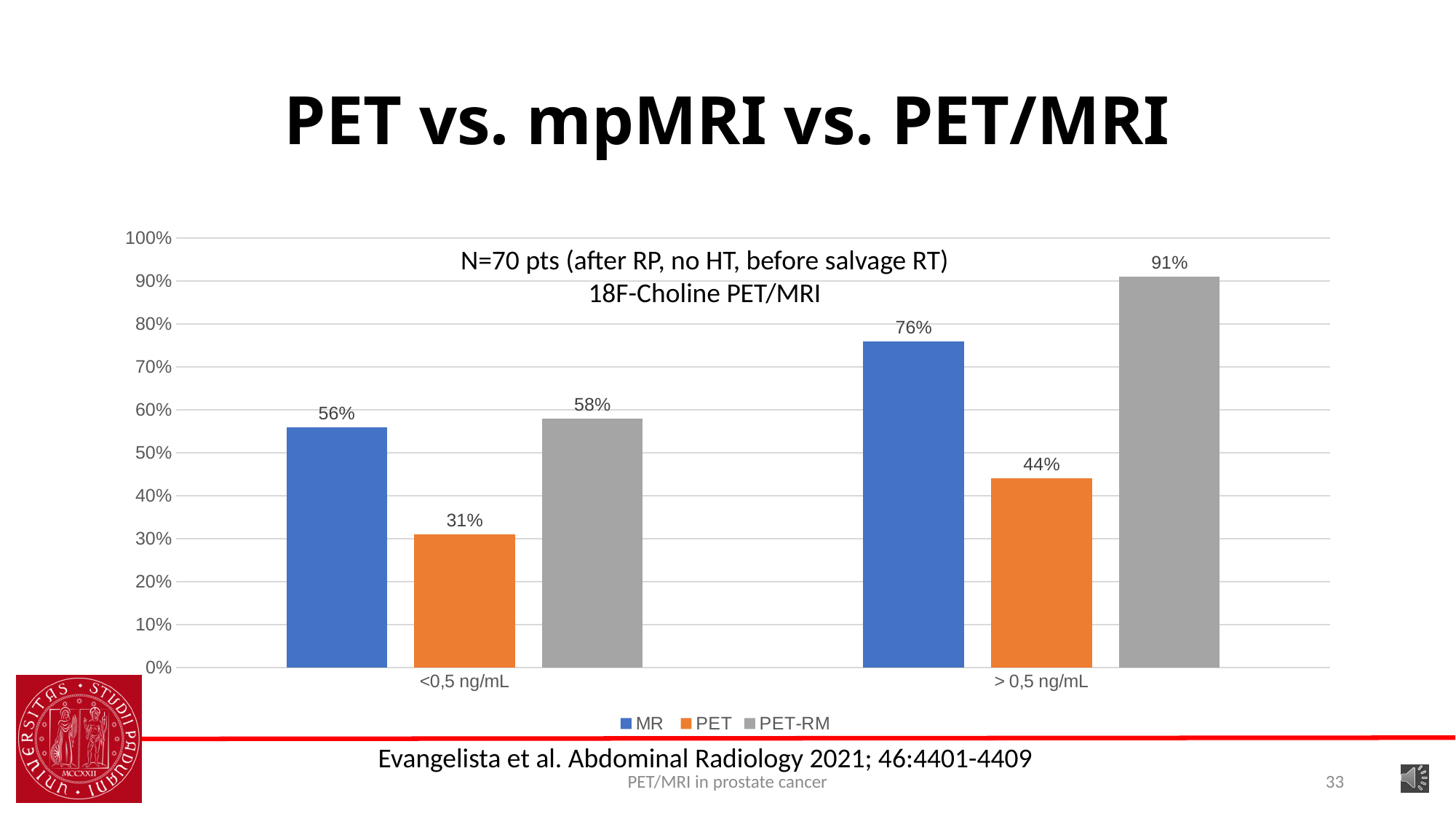
Which series has the highest value in the > 0,5 ng/mL category? PET-RM What is the value for MR in the <0,5 ng/mL category? 56% What kind of chart is shown on the slide? Bar chart Which is larger: the MR value for <0,5 ng/mL or the PET-RM value for <0,5 ng/mL? PET-RM What is the value for PET in the > 0,5 ng/mL category? 44% What is the difference between the PET values for > 0,5 ng/mL and <0,5 ng/mL? 13% What is the value for PET in the <0,5 ng/mL category? 31% How many series does the legend list? 3 Which colour represents the PET series in the chart? Orange What is the value for PET-RM in the > 0,5 ng/mL category? 91% What is the difference between the PET-RM and MR values in the > 0,5 ng/mL category? 15% Which series has the lowest value in the <0,5 ng/mL category? PET